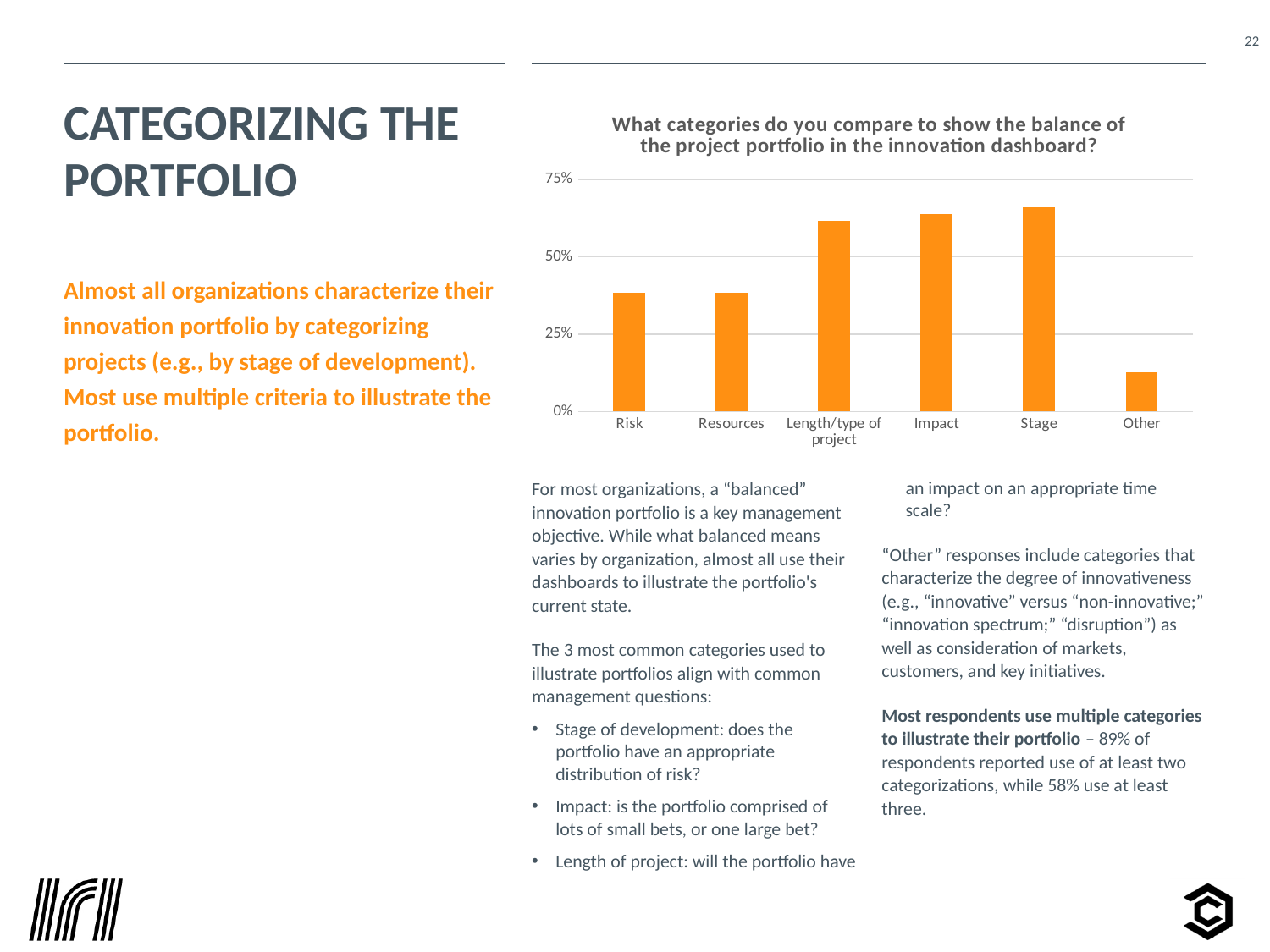
How many categories are shown on the x axis of the chart? 6 Is the value for Stage greater or less than 50%? greater Is the value for Risk greater or less than 25%? greater Which category has the lowest value in the chart? Other What colour are the bars in the chart? orange Which is larger, the value for Other or the value for Resources? Resources What kind of chart is shown on the slide? bar chart Is the value for Resources greater or less than 50%? less Which is larger, the value for Stage or the value for Risk? Stage What is the title of the chart? What categories do you compare to show the balance of the project portfolio in the innovation dashboard?